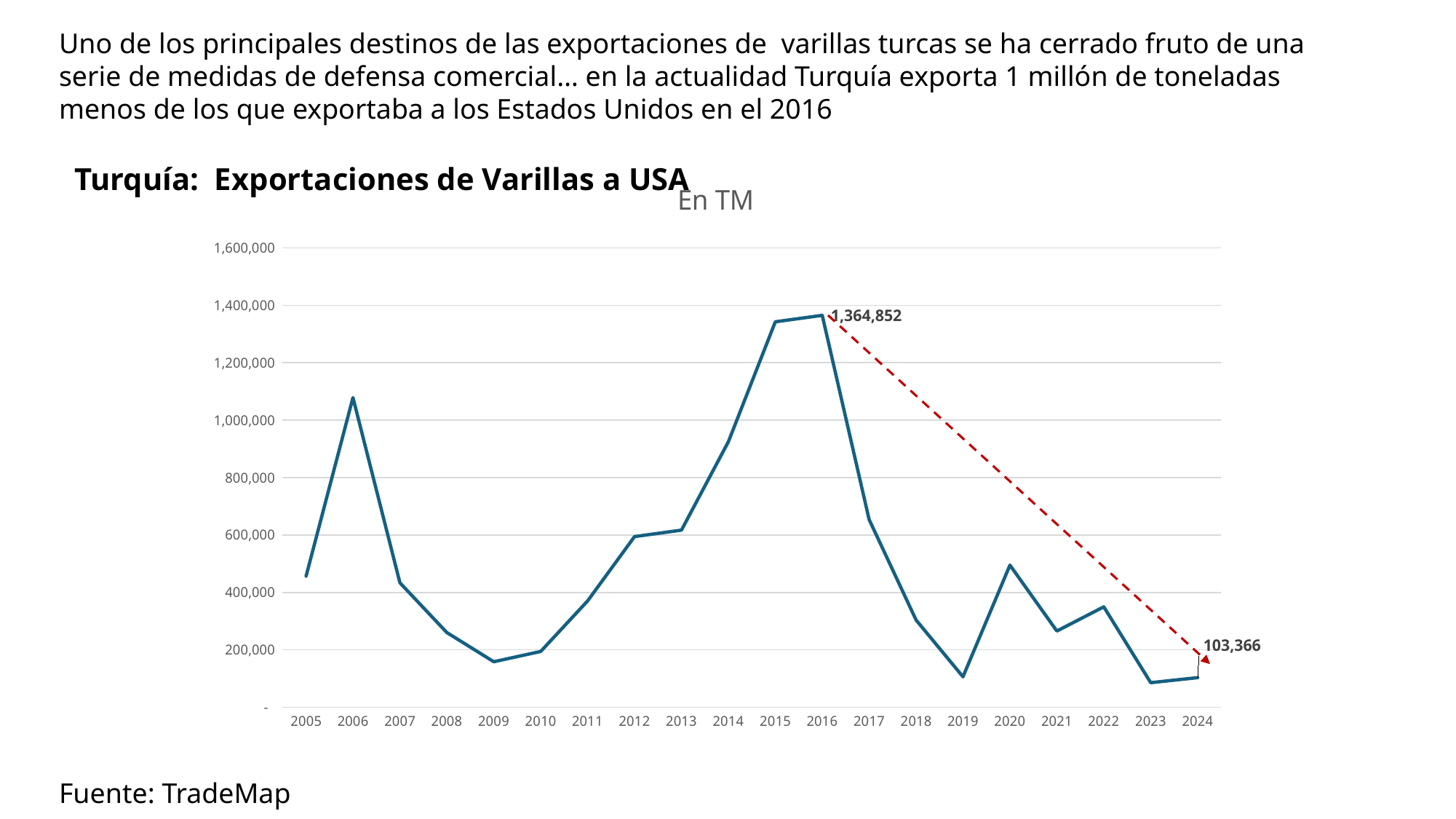
Is the value for 2020 greater or less than 400,000? greater Is the value for 2006 greater or less than 1,000,000? greater Which year has the larger export value, 2006 or 2012? 2006 How many years are plotted on the x axis? 20 What is the value of Turkey's rebar exports to the USA in 2024? 103,366 In what unit are the values on the chart expressed? TM Do the values rise or fall from 2016 to 2019? fall Is the value for 2009 greater or less than 200,000? less Which year has the highest export value on the chart? 2016 What is the difference between the 2016 value and the 2024 value? 1,261,486 What kind of chart is shown on the slide? line chart What is the value of Turkey's rebar exports to the USA in 2016? 1,364,852